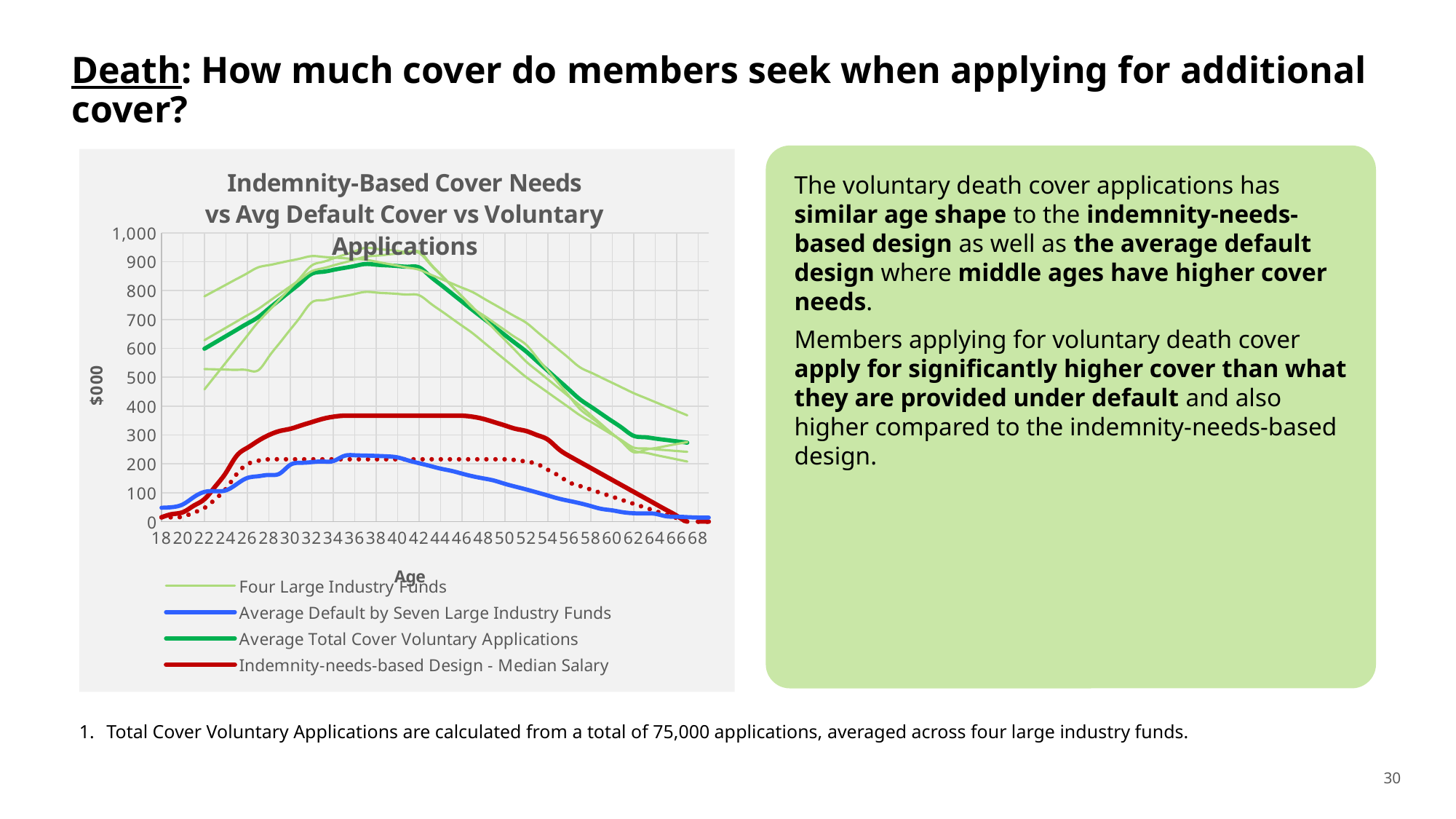
What is the label on the vertical axis of the chart? $000 What is the label on the horizontal axis of the chart? Age Is the value for Average Default by Seven Large Industry Funds at age 40 greater or less than 300? less Is the value for Average Default by Seven Large Industry Funds at age 66 greater or less than 100? less What kind of chart is shown on the slide? line chart At age 40, which is larger: Average Total Cover Voluntary Applications or Average Default by Seven Large Industry Funds? Average Total Cover Voluntary Applications Does the Indemnity-needs-based Design - Median Salary line rise or fall from age 18 to age 34? rise Is the value for Average Total Cover Voluntary Applications at age 40 greater or less than 800? greater How many series does the chart legend list? 4 Does the Average Default by Seven Large Industry Funds line rise or fall from age 40 to age 68? fall